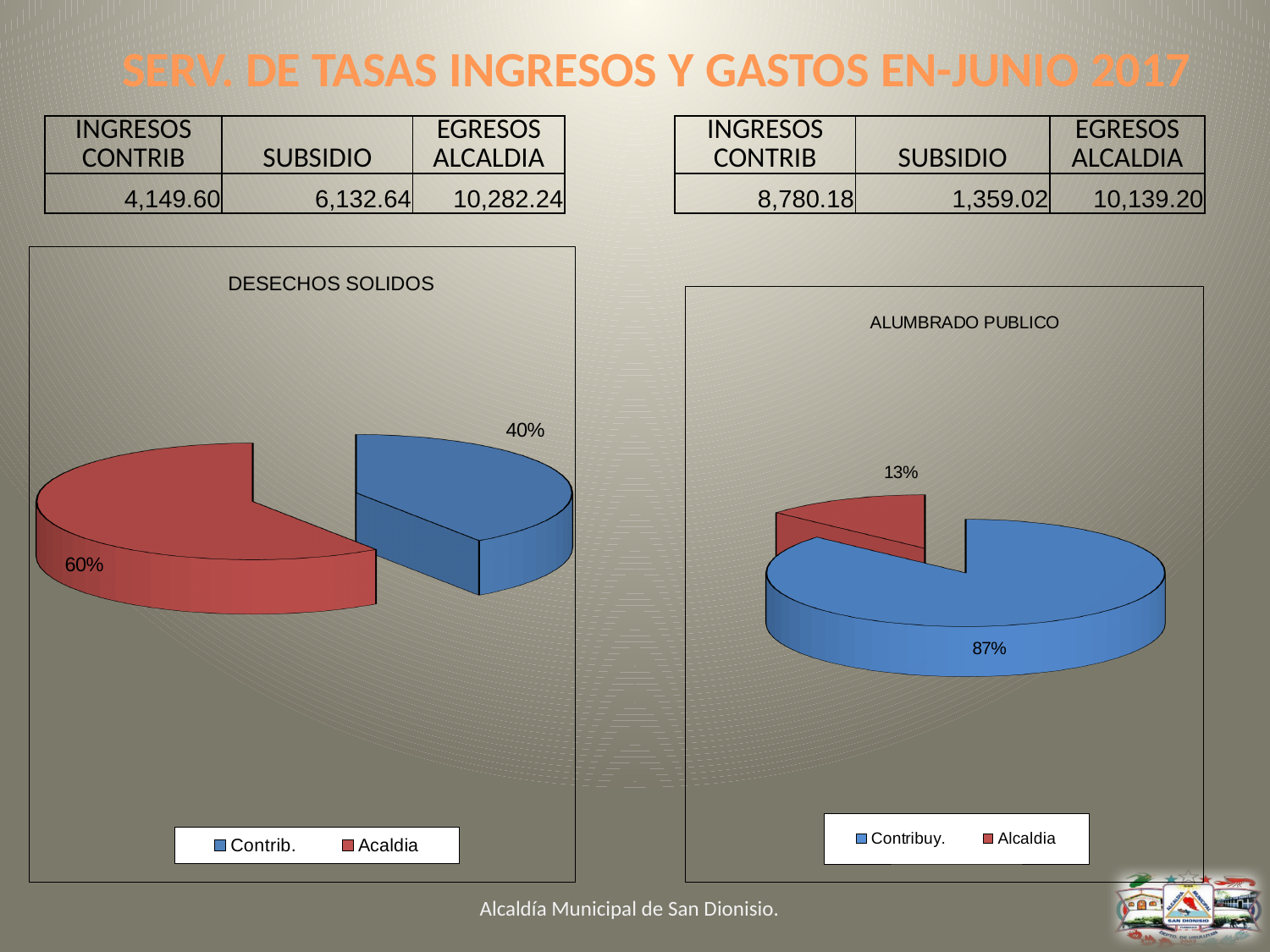
What kind of chart is the DESECHOS SOLIDOS chart? Pie chart In the ALUMBRADO PUBLICO chart, which is larger, Contribuy. or Alcaldia? Contribuy. In the ALUMBRADO PUBLICO chart, what share does Contribuy. have? 87% How many slices does the ALUMBRADO PUBLICO chart have? 2 In the DESECHOS SOLIDOS chart, what share does Acaldia have? 60% In the ALUMBRADO PUBLICO chart, what is the difference between the Contribuy. and Alcaldia shares? 74% In the ALUMBRADO PUBLICO chart, which slice is the smallest? Alcaldia How many entries does the legend of the DESECHOS SOLIDOS chart list? 2 In the DESECHOS SOLIDOS chart, which slice is the largest? Acaldia In the DESECHOS SOLIDOS chart, what share does Contrib. have? 40% In the DESECHOS SOLIDOS chart, what is the difference between the Acaldia and Contrib. shares? 20% In the ALUMBRADO PUBLICO chart, what share does Alcaldia have? 13%